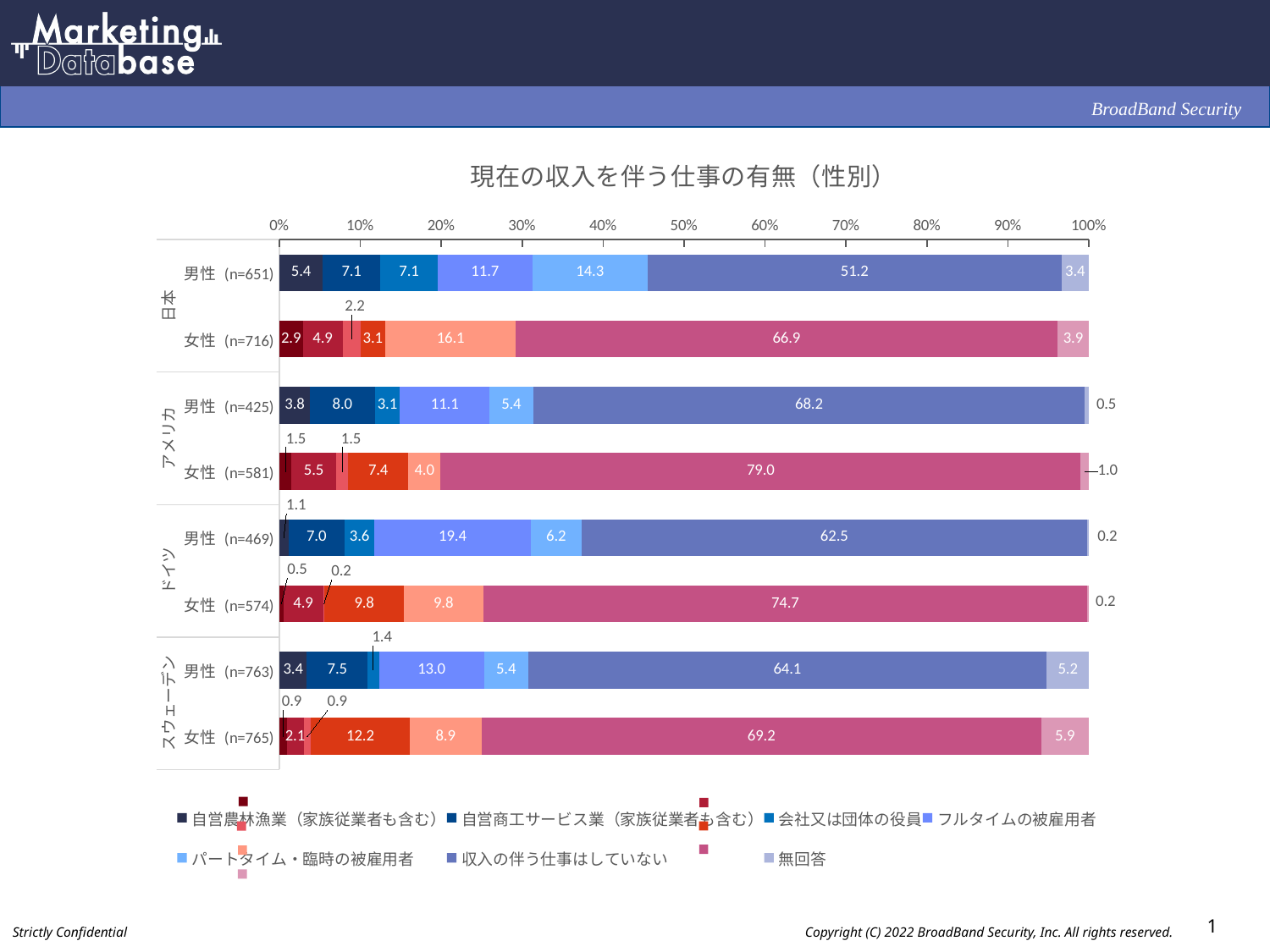
Which is larger, the 無回答 value for スウェーデン 女性 (n=765) or for スウェーデン 男性 (n=763)? スウェーデン 女性 (n=765) How many series does the legend list? 7 What kind of chart is shown on the slide? Stacked bar chart Which group has the lowest value for 収入の伴う仕事はしていない? 日本 男性 (n=651) What is the difference between the 収入の伴う仕事はしていない values for 日本 女性 (n=716) and 日本 男性 (n=651)? 15.7 What is the value of 自営商工サービス業（家族従業者も含む） for スウェーデン 女性 (n=765)? 2.1 What is the value of フルタイムの被雇用者 for ドイツ 男性 (n=469)? 19.4 How many bars (country/gender groups) are plotted in the chart? 8 Which group has the highest value for 収入の伴う仕事はしていない? アメリカ 女性 (n=581) What is the value of パートタイム・臨時の被雇用者 for 日本 女性 (n=716)? 16.1 What is the title of the chart? 現在の収入を伴う仕事の有無（性別） What is the value of 収入の伴う仕事はしていない for 日本 男性 (n=651)? 51.2